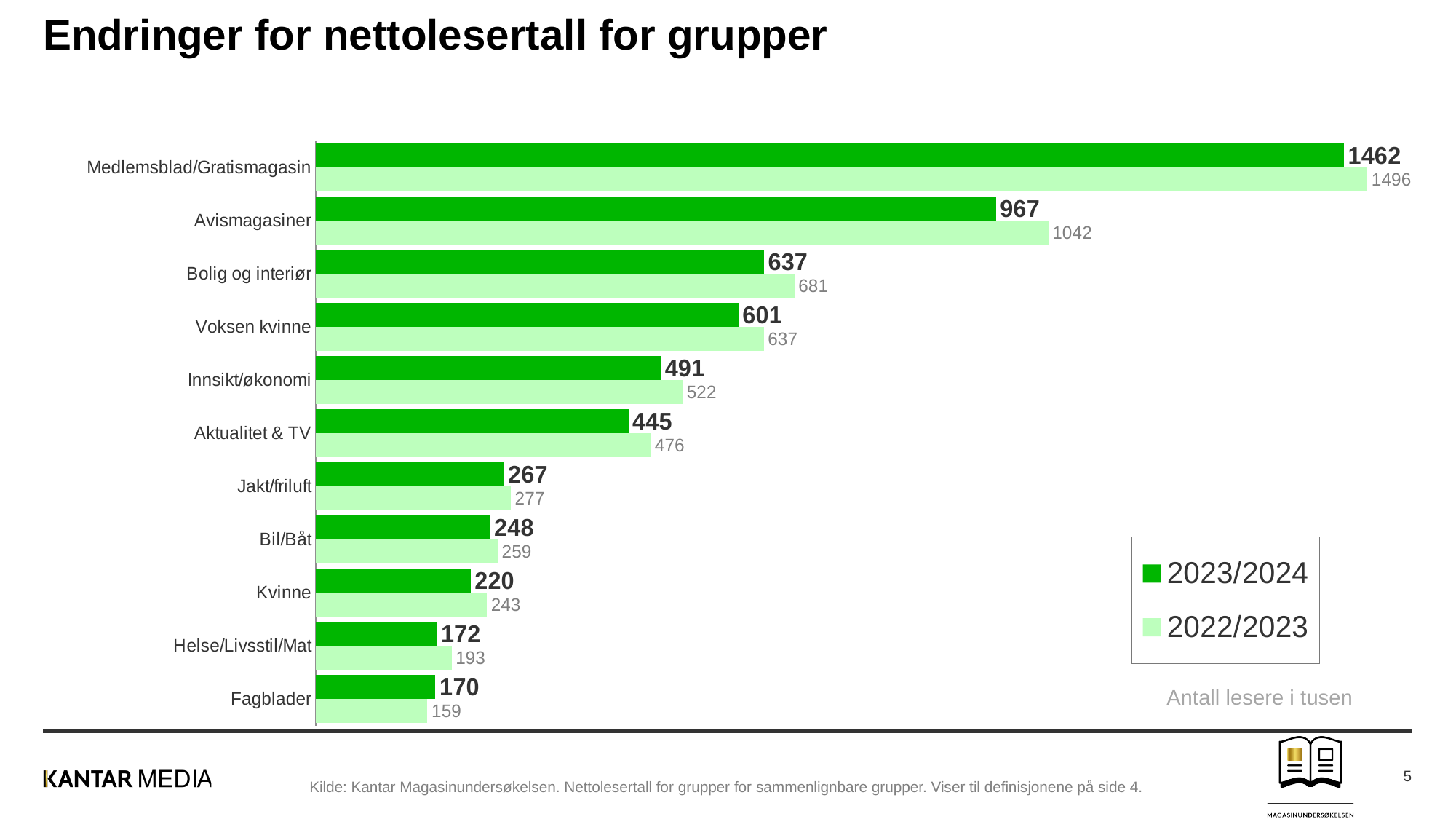
What kind of chart is shown on the slide? Bar chart What is the 2023/2024 value for Avismagasiner? 967 What unit does the chart say the values are in? Antall lesere i tusen For Fagblader, which is larger: the 2023/2024 value or the 2022/2023 value? 2023/2024 How many categories are shown on the chart? 11 What is the difference between the 2022/2023 and 2023/2024 values for Medlemsblad/Gratismagasin? 34 What is the 2022/2023 value for Bolig og interiør? 681 What is the 2023/2024 value for Helse/Livsstil/Mat? 172 How many series does the legend list? 2 Which category has the lowest 2022/2023 value? Fagblader What is the difference between the 2022/2023 and 2023/2024 values for Avismagasiner? 75 Which category has the highest 2023/2024 value? Medlemsblad/Gratismagasin